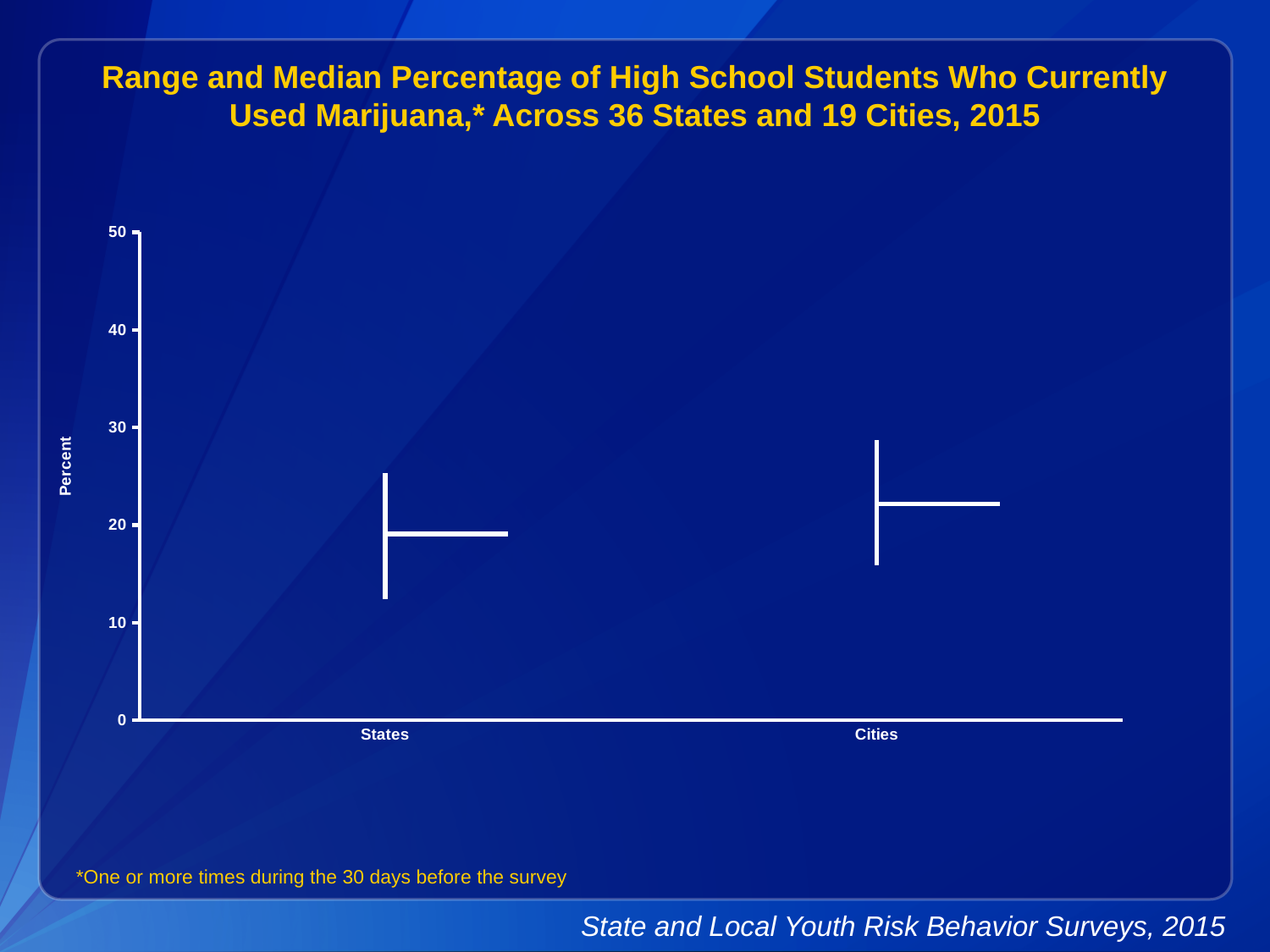
What is the label on the vertical axis? Percent Which category has the higher median percentage, States or Cities? Cities Is the top of the range for Cities greater or less than 30? less What is the maximum value shown on the vertical axis? 50 What is the title of the chart? Range and Median Percentage of High School Students Who Currently Used Marijuana,* Across 36 States and 19 Cities, 2015 Which category has the lower bottom of its range, States or Cities? States Is the bottom of the range for Cities greater or less than 20? less Is the median value for States greater or less than 30? less Which category has the higher top of its range, States or Cities? Cities How many categories are shown on the x axis? 2